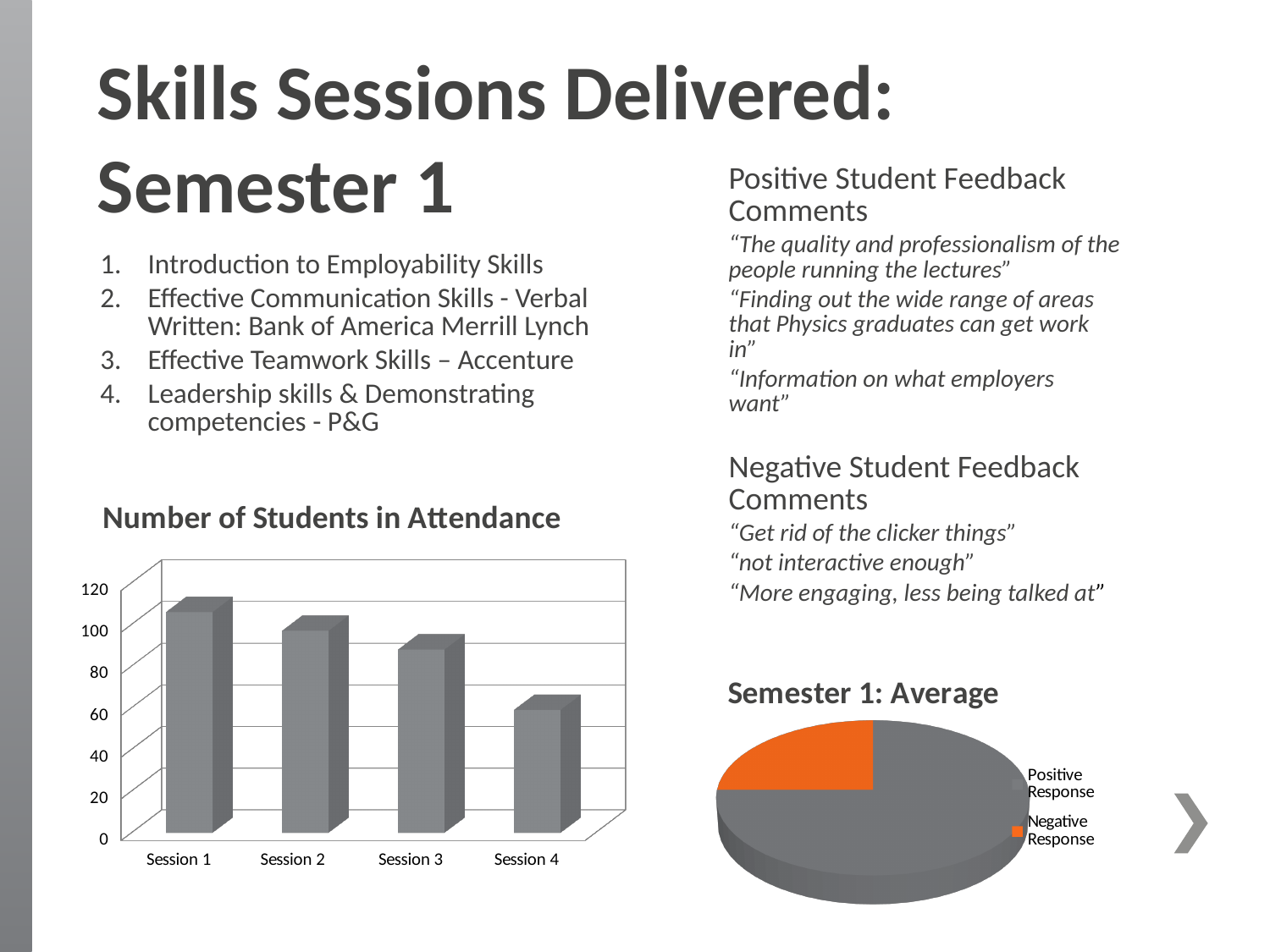
In the "Semester 1: Average" pie chart, what colour is the Negative Response slice? orange In the "Number of Students in Attendance" chart, which has the larger value, Session 2 or Session 4? Session 2 In the "Number of Students in Attendance" chart, which session has the highest attendance? Session 1 In the "Number of Students in Attendance" chart, which session has the lowest attendance? Session 4 In the "Number of Students in Attendance" chart, is the value for Session 4 greater or less than 80? less In the "Semester 1: Average" pie chart, which slice is larger, Positive Response or Negative Response? Positive Response What kind of chart is "Semester 1: Average"? pie chart In the "Number of Students in Attendance" chart, do the values rise or fall from Session 1 to Session 4? fall What kind of chart is "Number of Students in Attendance"? bar chart How many entries does the legend of the "Semester 1: Average" pie chart list? 2 In the "Number of Students in Attendance" chart, is the value for Session 2 greater or less than 80? greater In the "Number of Students in Attendance" chart, how many sessions are shown on the x axis? 4